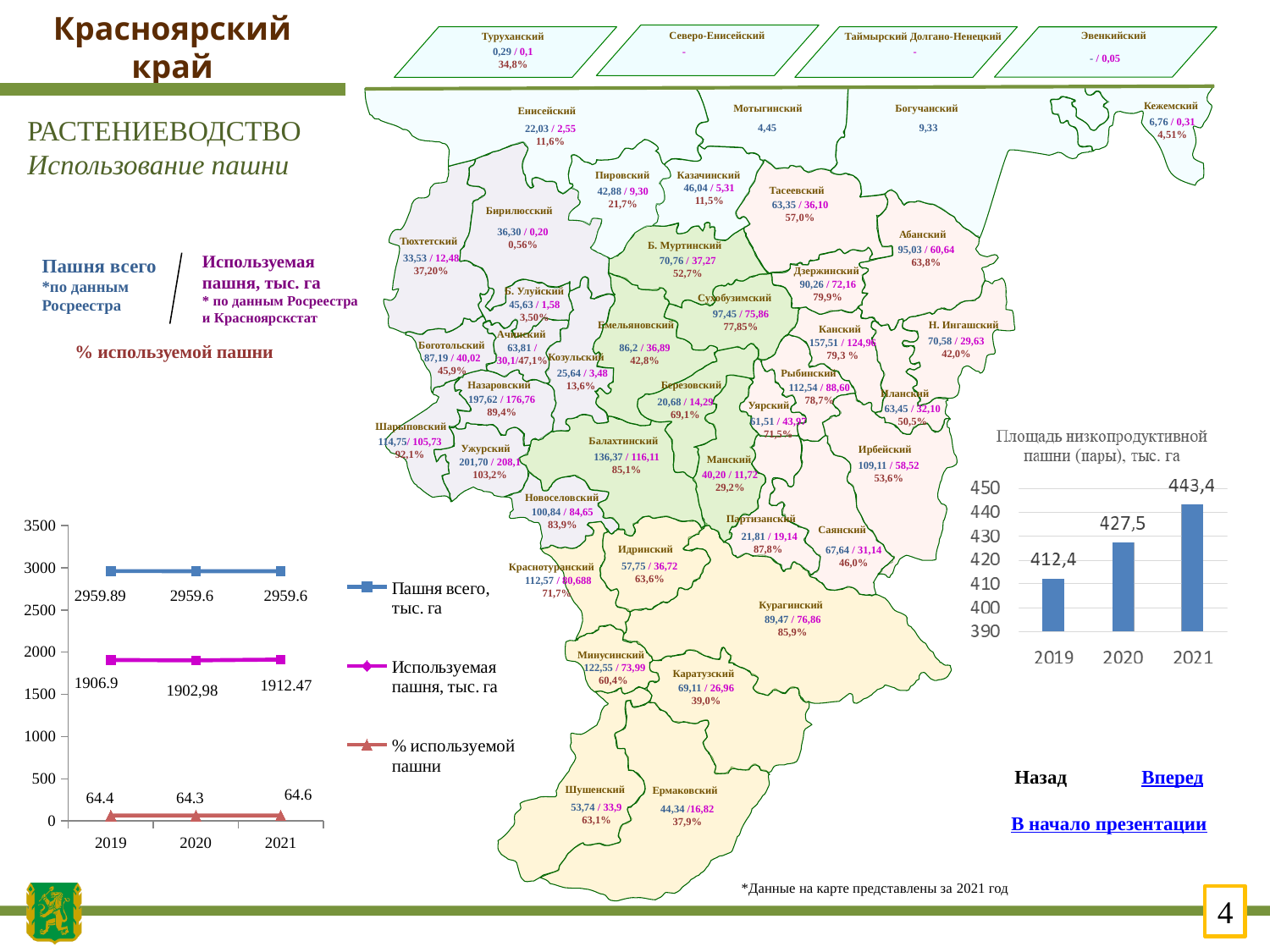
In the bar chart titled "Площадь низкопродуктивной пашни (пары), тыс. га", do the values rise or fall from 2019 to 2021? rise In the bar chart titled "Площадь низкопродуктивной пашни (пары), тыс. га", what is the value for 2021? 443,4 In the line chart at the bottom left of the slide, what is the value of "Используемая пашня, тыс. га" for 2021? 1912.47 In the bar chart titled "Площадь низкопродуктивной пашни (пары), тыс. га", how many bars are plotted? 3 In the bar chart titled "Площадь низкопродуктивной пашни (пары), тыс. га", which year has the highest value? 2021 How many series does the legend of the line chart at the bottom left of the slide list? 3 In the line chart at the bottom left of the slide, what is the value of "% используемой пашни" for 2020? 64.3 What kind of chart is the chart titled "Площадь низкопродуктивной пашни (пары), тыс. га"? bar chart In the line chart at the bottom left of the slide, which is larger: "Пашня всего, тыс. га" for 2021 or "Используемая пашня, тыс. га" for 2021? Пашня всего, тыс. га In the bar chart titled "Площадь низкопродуктивной пашни (пары), тыс. га", what is the value for 2019? 412,4 In the bar chart titled "Площадь низкопродуктивной пашни (пары), тыс. га", which year has the lowest value? 2019 In the line chart at the bottom left of the slide, what is the value of "Пашня всего, тыс. га" for 2019? 2959.89